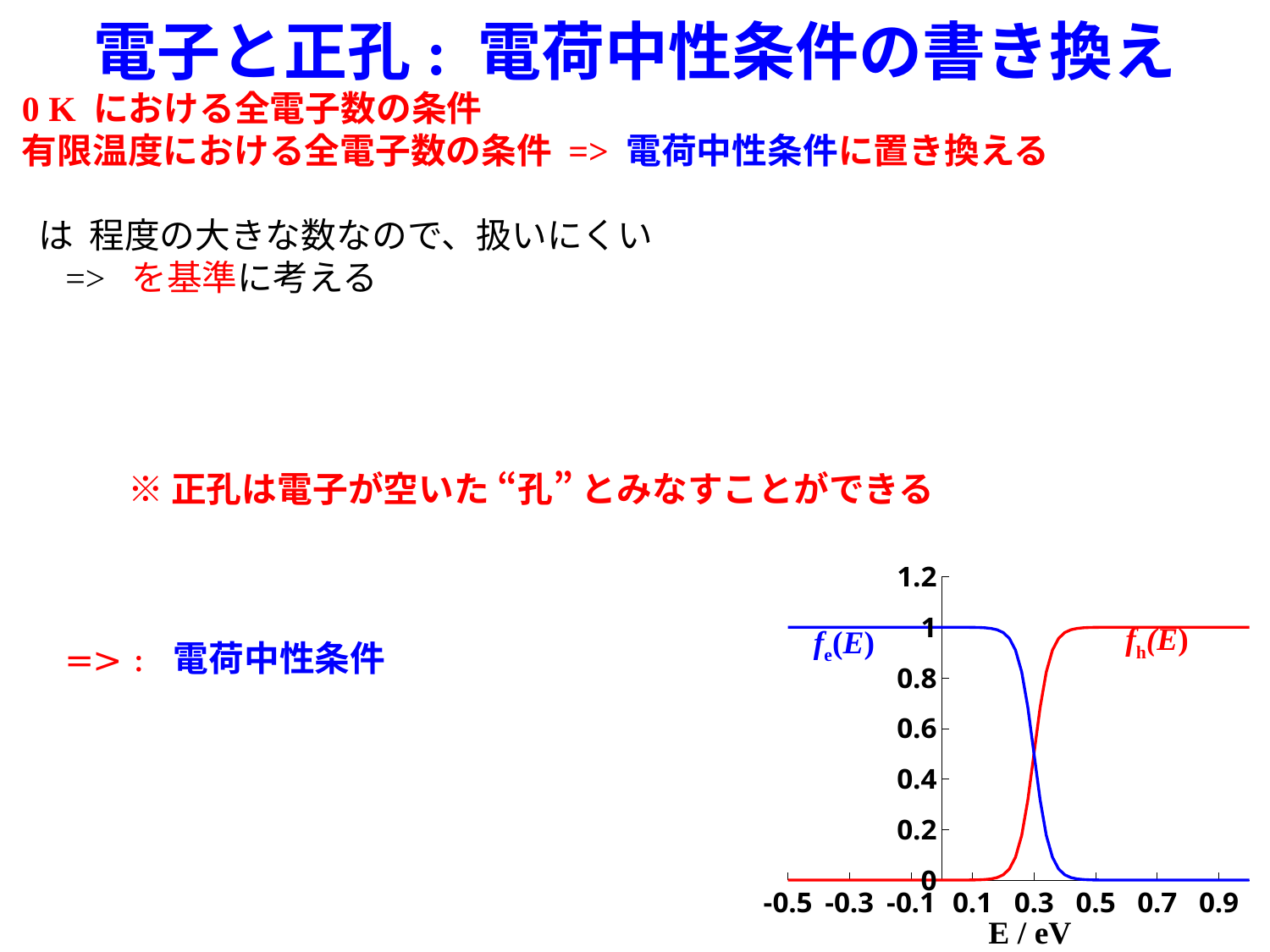
How many curves (series) are plotted on the chart? 2 Is the value of f_e(E) at E = 0.9 greater or less than 0.2? less Is the value of f_h(E) at E = -0.5 greater or less than 0.2? less What is the label of the x axis of the chart? E / eV At E = 0.5, which curve has the larger value, f_e(E) or f_h(E)? f_h(E) Does the f_h(E) curve rise or fall as E increases along the x axis? rise Is the value of f_h(E) at E = 0.9 greater or less than 0.8? greater What kind of chart is shown on the slide? line chart At E = 0.1, which curve has the larger value, f_e(E) or f_h(E)? f_e(E) Which colour is the f_e(E) curve drawn in? blue Does the f_e(E) curve rise or fall as E increases along the x axis? fall